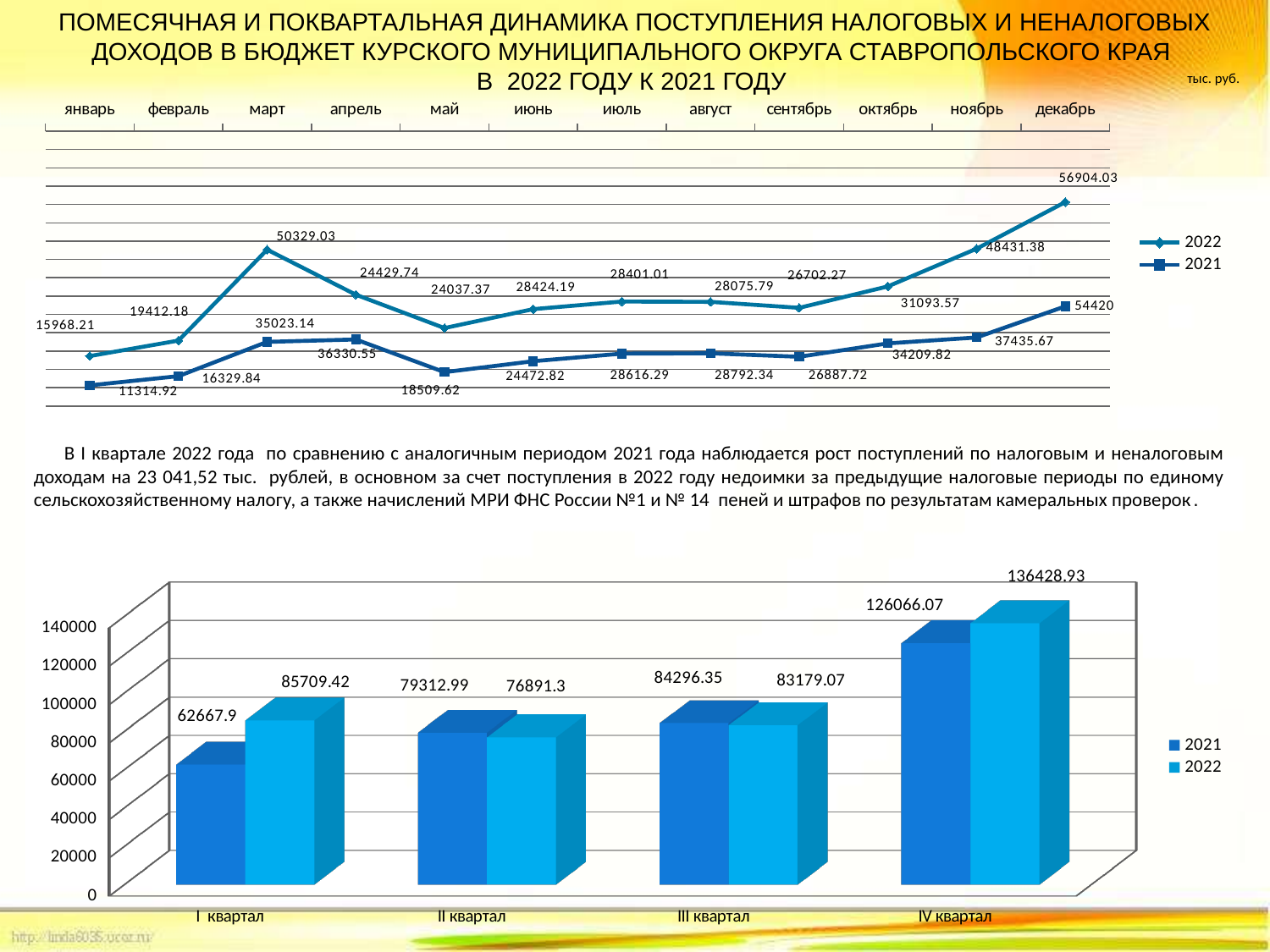
In the bottom bar chart, what is the value for 2021 in I квартал? 62667.9 In the top line chart, which month has the lowest value for the 2021 series? январь In the bottom bar chart, what is the difference between the 2022 and 2021 values in I квартал? 23041.52 What kind of chart is the top chart on the slide? line chart In the top line chart, what is the value for 2022 in March (март)? 50329.03 In the top line chart, how many series does the legend list? 2 In the top line chart, what is the difference between the 2022 and 2021 values in January (январь)? 4653.29 In the top line chart, what is the value for 2021 in December (декабрь)? 54420 In the bottom bar chart, which is larger in II квартал: 2021 or 2022? 2021 In the top line chart, which month has the highest value for the 2022 series? декабрь How many quarters (categories) are shown in the bottom bar chart? 4 In the bottom bar chart, what is the value for 2022 in IV квартал? 136428.93